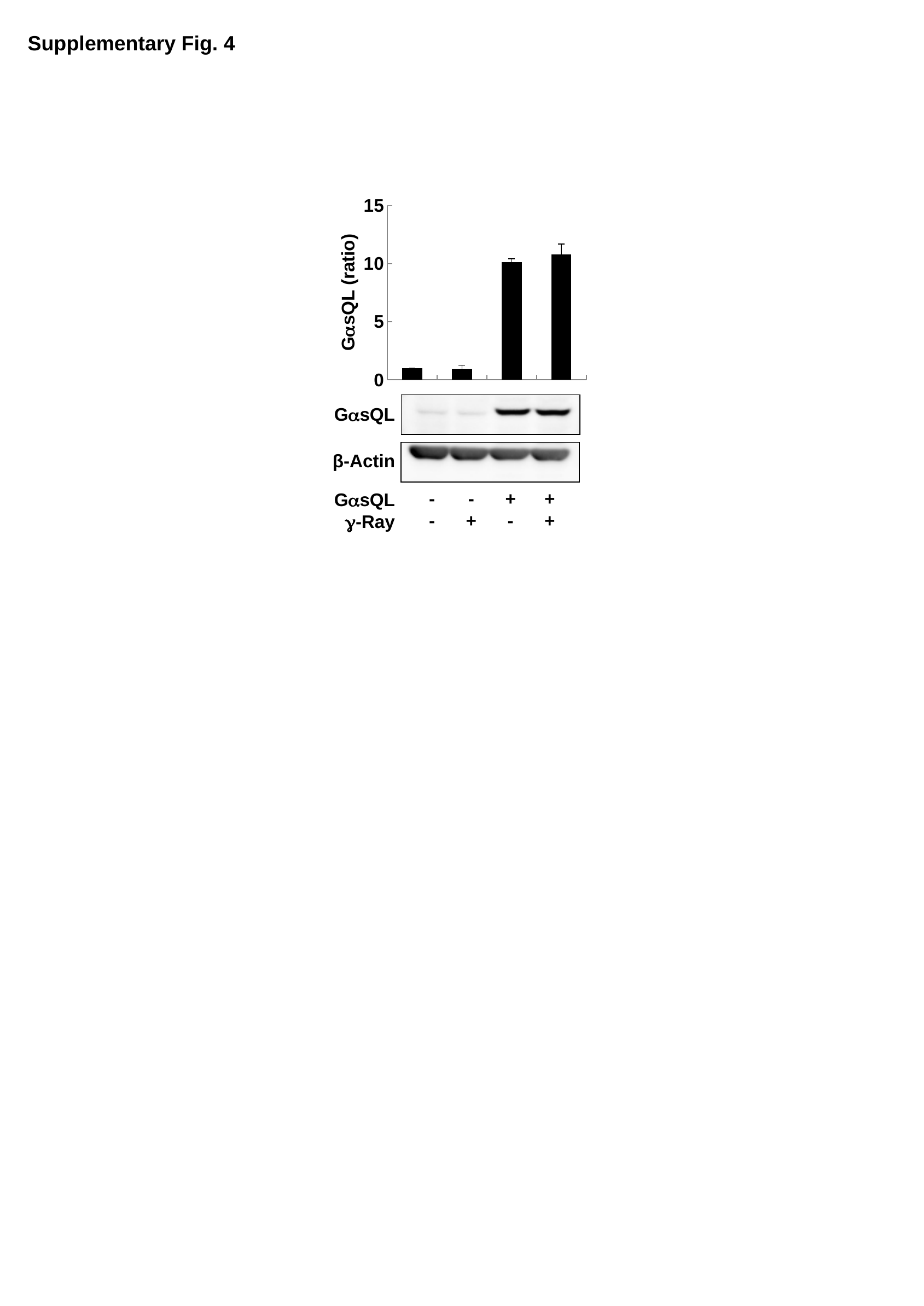
Is the value for the first bar (GαsQL -, γ-Ray -) greater or less than 5? less What kind of chart is shown on the slide? bar chart What is the highest tick value shown on the y axis? 15 Is the value for the third bar (GαsQL +, γ-Ray -) greater or less than 5? greater Is the value for the fourth bar (GαsQL +, γ-Ray +) greater or less than 5? greater What is the label of the y axis of the chart? GαsQL (ratio) How many bars are plotted in the chart? 4 Which is larger, the value for the second bar (GαsQL -, γ-Ray +) or the fourth bar (GαsQL +, γ-Ray +)? the fourth bar (GαsQL +, γ-Ray +) Do the bar values generally rise or fall from left to right along the x axis? rise Which is larger, the value for the first bar (GαsQL -, γ-Ray -) or the third bar (GαsQL +, γ-Ray -)? the third bar (GαsQL +, γ-Ray -)